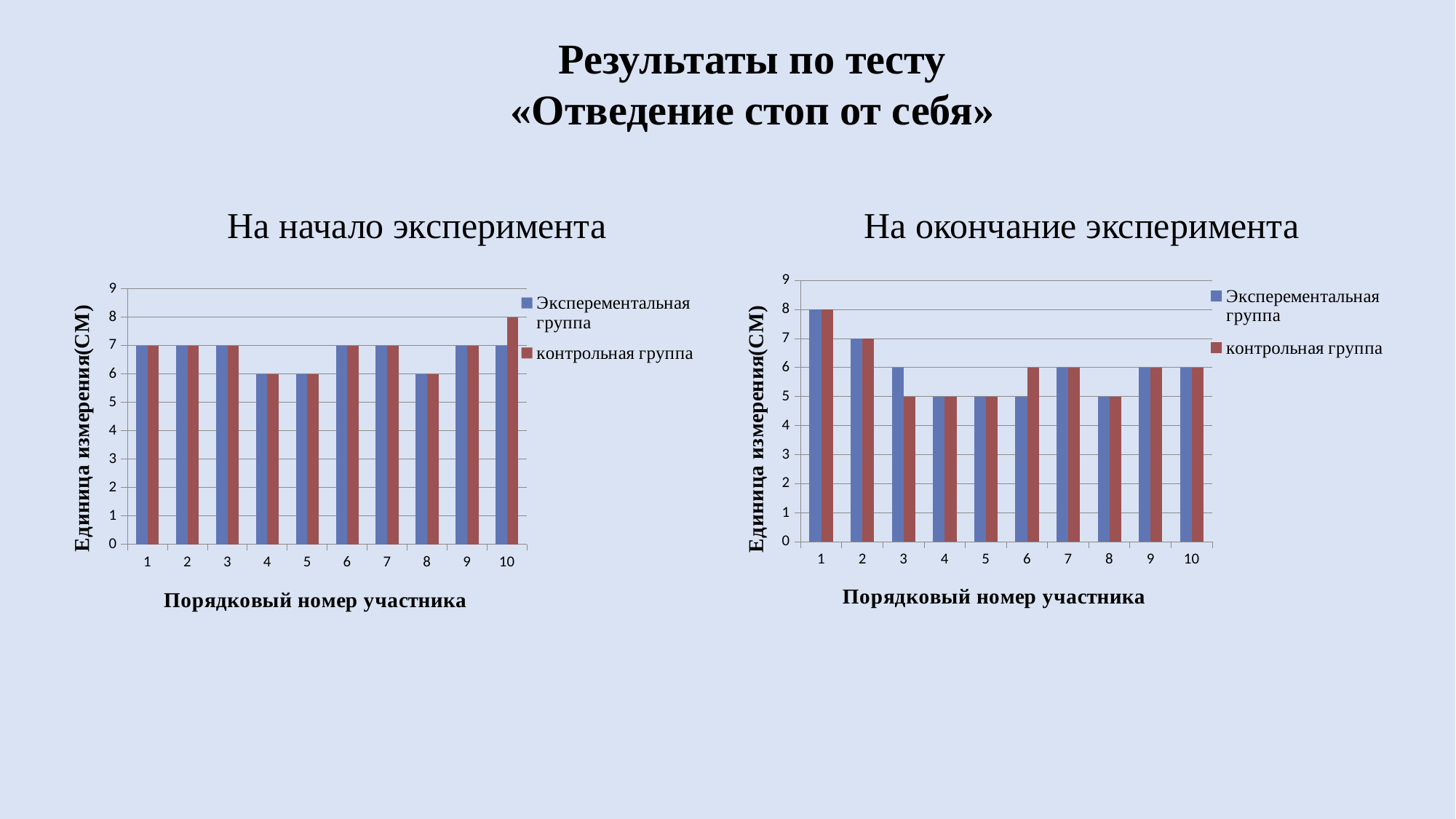
On the chart 'На начало эксперимента', which participant has the highest value for the контрольная группа? 10 What type of chart is 'На окончание эксперимента'? bar chart On the chart 'На начало эксперимента', which is larger for participant 10: the Экспериментальная группа or the контрольная группа? контрольная группа How many series does the legend of the chart 'На окончание эксперимента' list? 2 How many participants are shown on the x axis of the chart 'На начало эксперимента'? 10 On the chart 'На окончание эксперимента', which is larger for participant 3: the Экспериментальная группа or the контрольная группа? Экспериментальная группа On the chart 'На окончание эксперимента', what is the value for the Экспериментальная группа for participant 1? 8 On the chart 'На начало эксперимента', what is the value for the контрольная группа for participant 10? 8 On the chart 'На окончание эксперимента', what is the difference between the Экспериментальная группа and контрольная группа values for participant 6? 1 On the chart 'На начало эксперимента', what is the value for the Экспериментальная группа for participant 4? 6 On the chart 'На окончание эксперимента', what is the value for the контрольная группа for participant 3? 5 On the chart 'На окончание эксперимента', which participant has the highest value for the Экспериментальная группа? 1